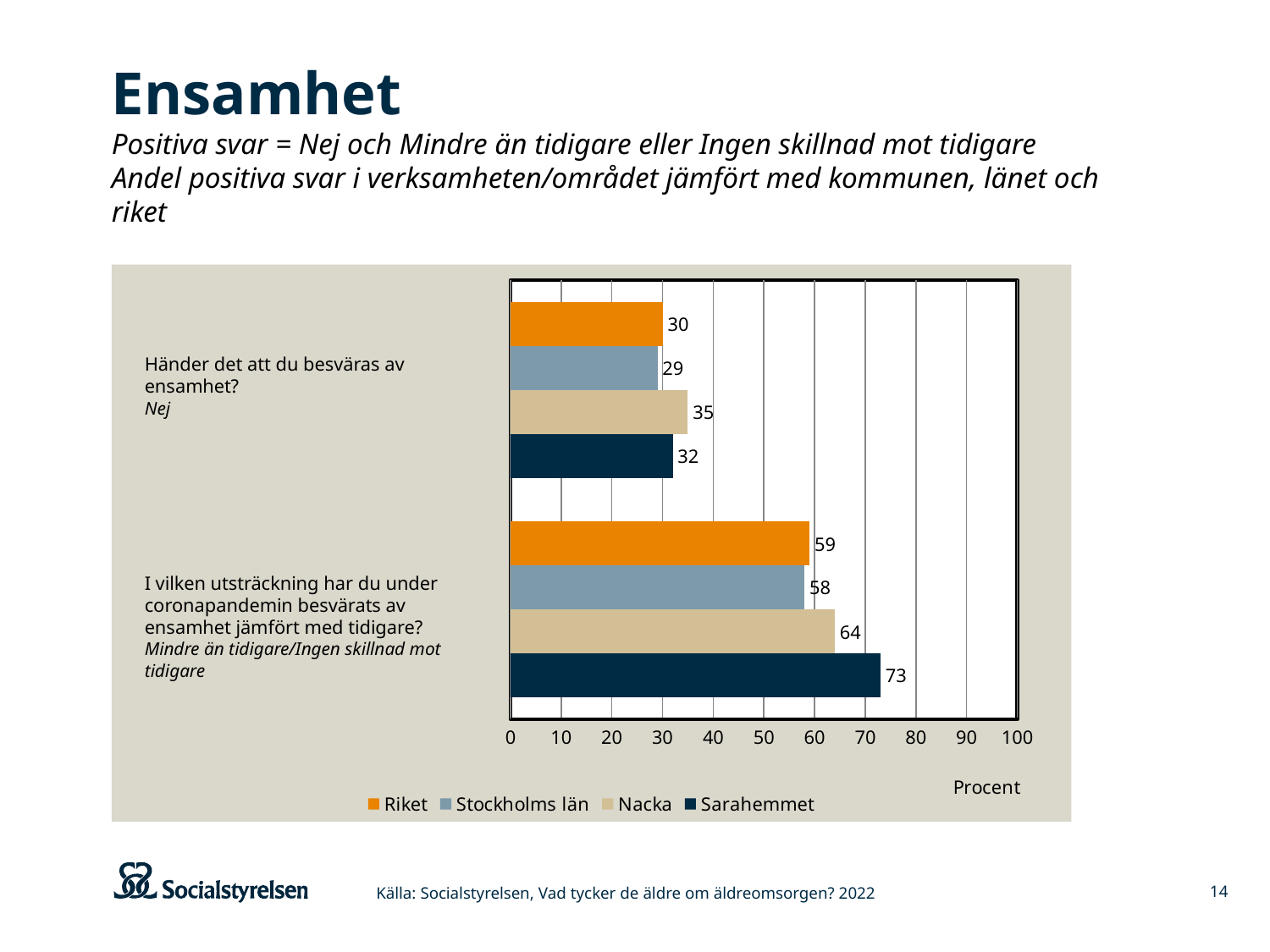
Which series has the highest value on the question "I vilken utsträckning har du under coronapandemin besvärats av ensamhet jämfört med tidigare?"? Sarahemmet Which series has the lowest value on the question "Händer det att du besväras av ensamhet?"? Stockholms län What kind of chart is shown on the slide? Bar chart What is the value for Nacka on the question "Händer det att du besväras av ensamhet?"? 35 What is the difference between Nacka and Sarahemmet on the question "Händer det att du besväras av ensamhet?"? 3 What is the value for Sarahemmet on the question "I vilken utsträckning har du under coronapandemin besvärats av ensamhet jämfört med tidigare?"? 73 What is the difference between Sarahemmet and Riket on the question "I vilken utsträckning har du under coronapandemin besvärats av ensamhet jämfört med tidigare?"? 14 Which is larger on the question "Händer det att du besväras av ensamhet?": Nacka or Riket? Nacka What is the value for Riket on the question "Händer det att du besväras av ensamhet?"? 30 How many series does the legend list? 4 What is the value for Stockholms län on the question "I vilken utsträckning har du under coronapandemin besvärats av ensamhet jämfört med tidigare?"? 58 What is the label of the x axis? Procent